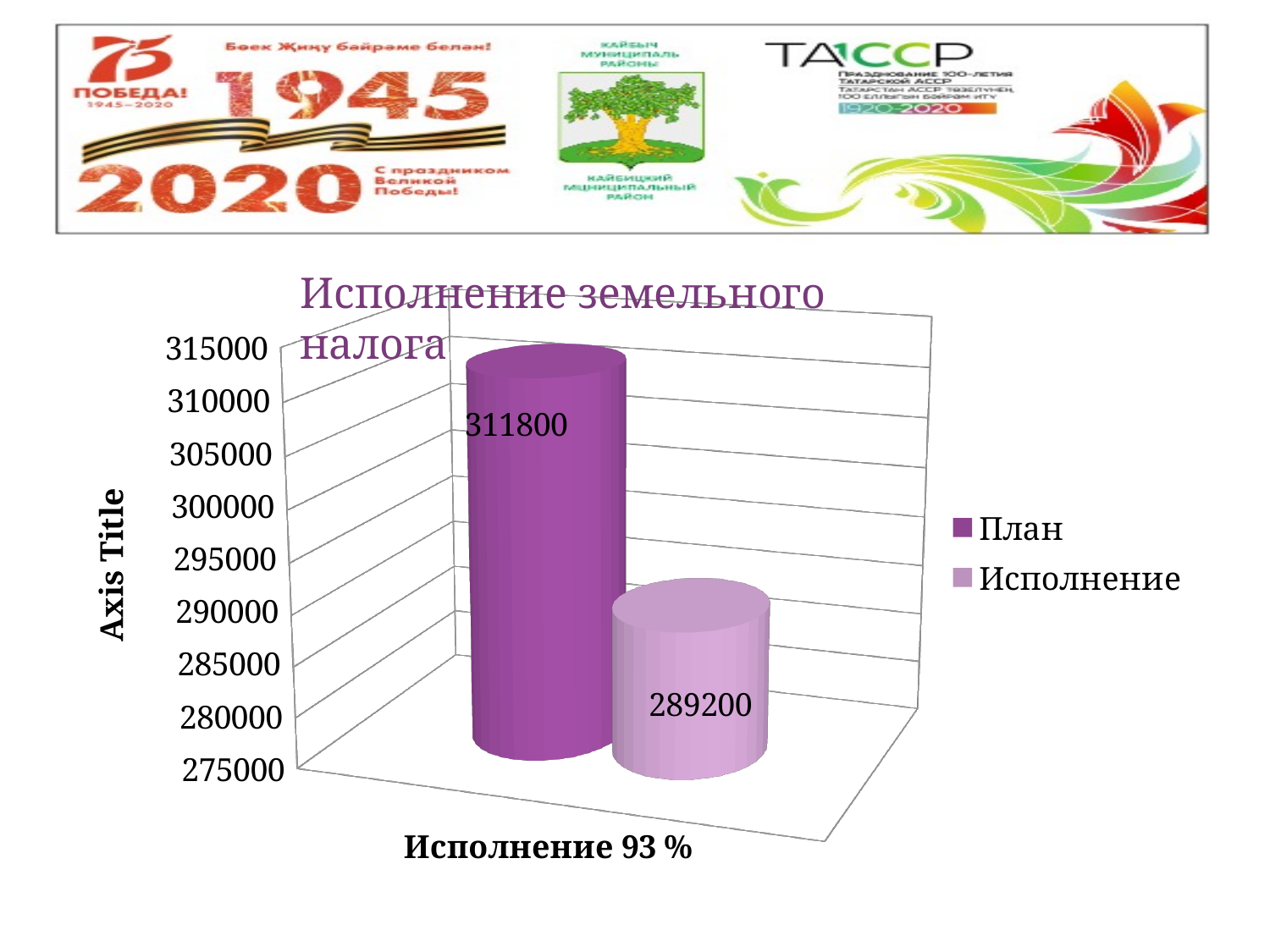
What kind of chart is shown on the slide? bar chart Is the value for Исполнение greater or less than 290000? less Which series has the higher value, План or Исполнение? План Which series has the lowest value in the chart? Исполнение What is the value for План (Plan) in the chart? 311800 What is the difference between the План value and the Исполнение value? 22600 How many series does the legend list? 2 Is the value for План greater or less than 310000? greater What is the label shown on the horizontal axis of the chart? Исполнение 93 % What is the value for Исполнение (Execution) in the chart? 289200 What is the title of the chart? Исполнение земельного налога